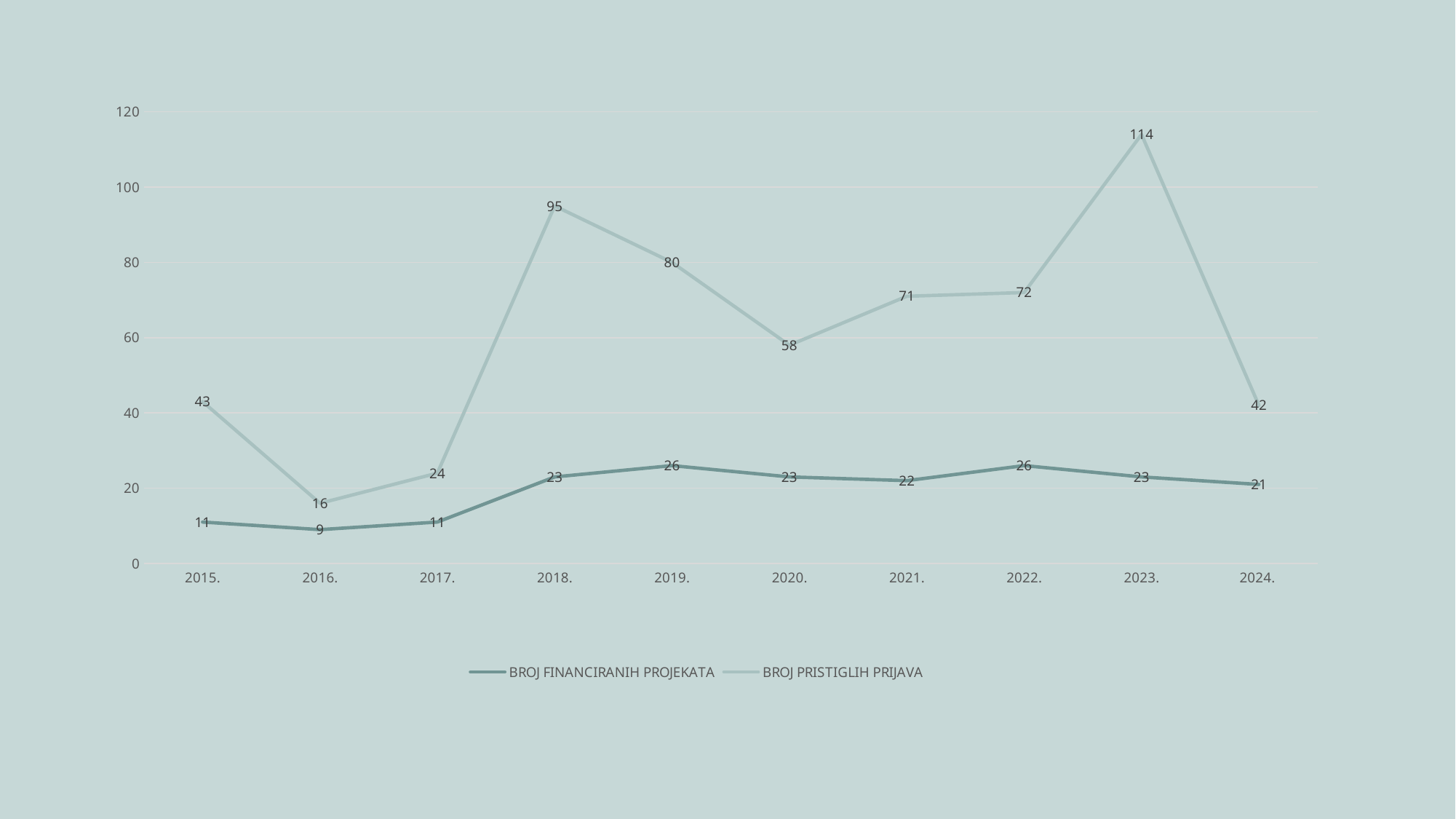
Which is larger: BROJ PRISTIGLIH PRIJAVA in 2019. or in 2020.? 2019. What is the name of the second series in the legend? BROJ PRISTIGLIH PRIJAVA What is the value of BROJ FINANCIRANIH PROJEKATA in 2016.? 9 Does BROJ PRISTIGLIH PRIJAVA rise or fall from 2023. to 2024.? Fall In which year is BROJ PRISTIGLIH PRIJAVA highest? 2023. What kind of chart is shown on the slide? Line chart What is the value of BROJ PRISTIGLIH PRIJAVA in 2015.? 43 How many years are plotted along the x axis? 10 In which year is BROJ FINANCIRANIH PROJEKATA lowest? 2016. What is the value of BROJ PRISTIGLIH PRIJAVA in 2018.? 95 How many series does the legend list? 2 What is the difference between BROJ PRISTIGLIH PRIJAVA and BROJ FINANCIRANIH PROJEKATA in 2023.? 91